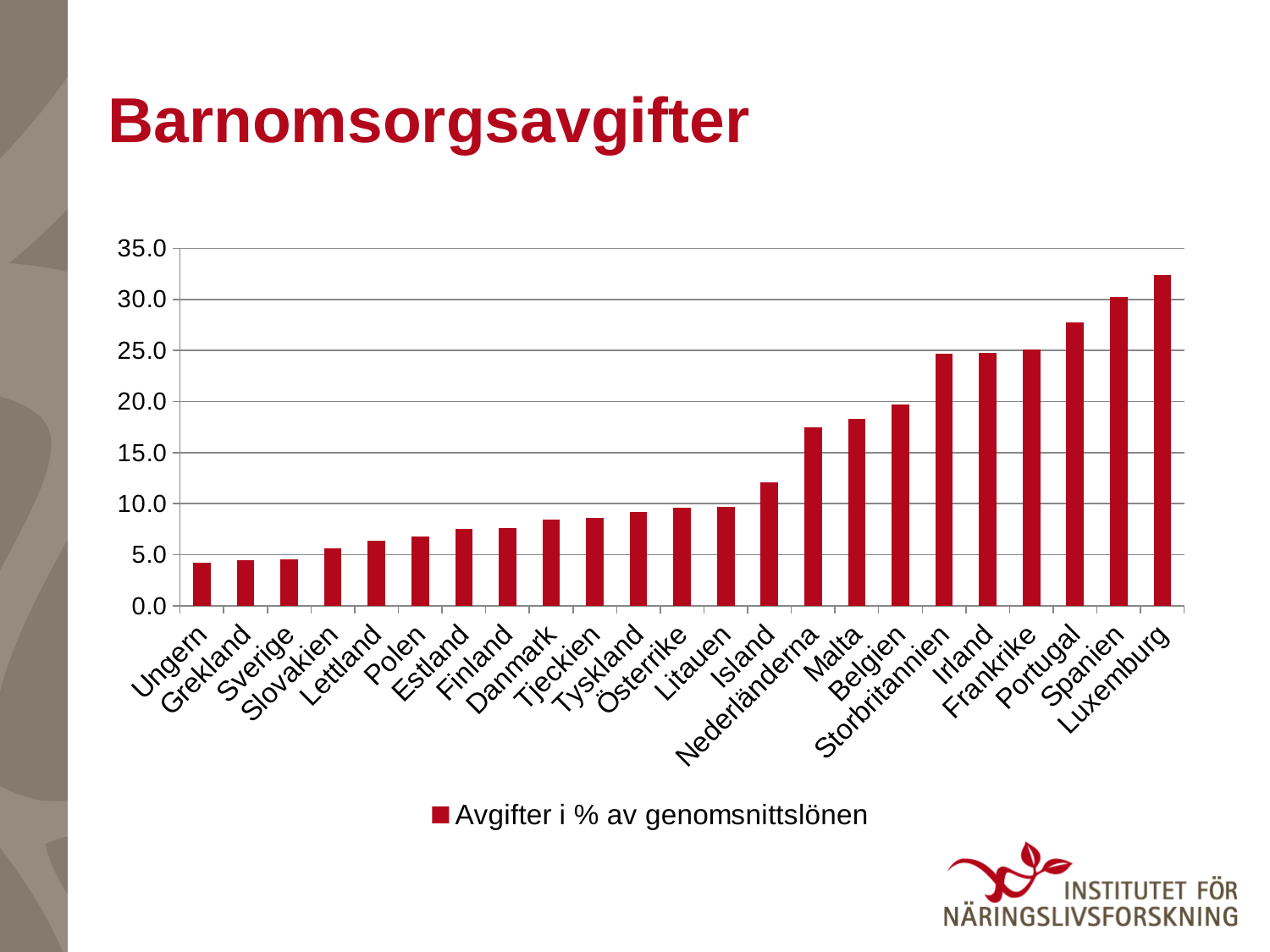
Which country has the highest value in the chart? Luxemburg How many countries are shown on the x axis of the chart? 23 What kind of chart is shown on the slide? bar chart Is the value for Luxemburg greater or less than 30.0? greater How many series does the legend list? 1 Is the value for Island greater or less than 10.0? greater Which has a larger value, Portugal or Island? Portugal Is the value for Danmark greater or less than 10.0? less Do the values rise or fall from left to right along the x axis? rise